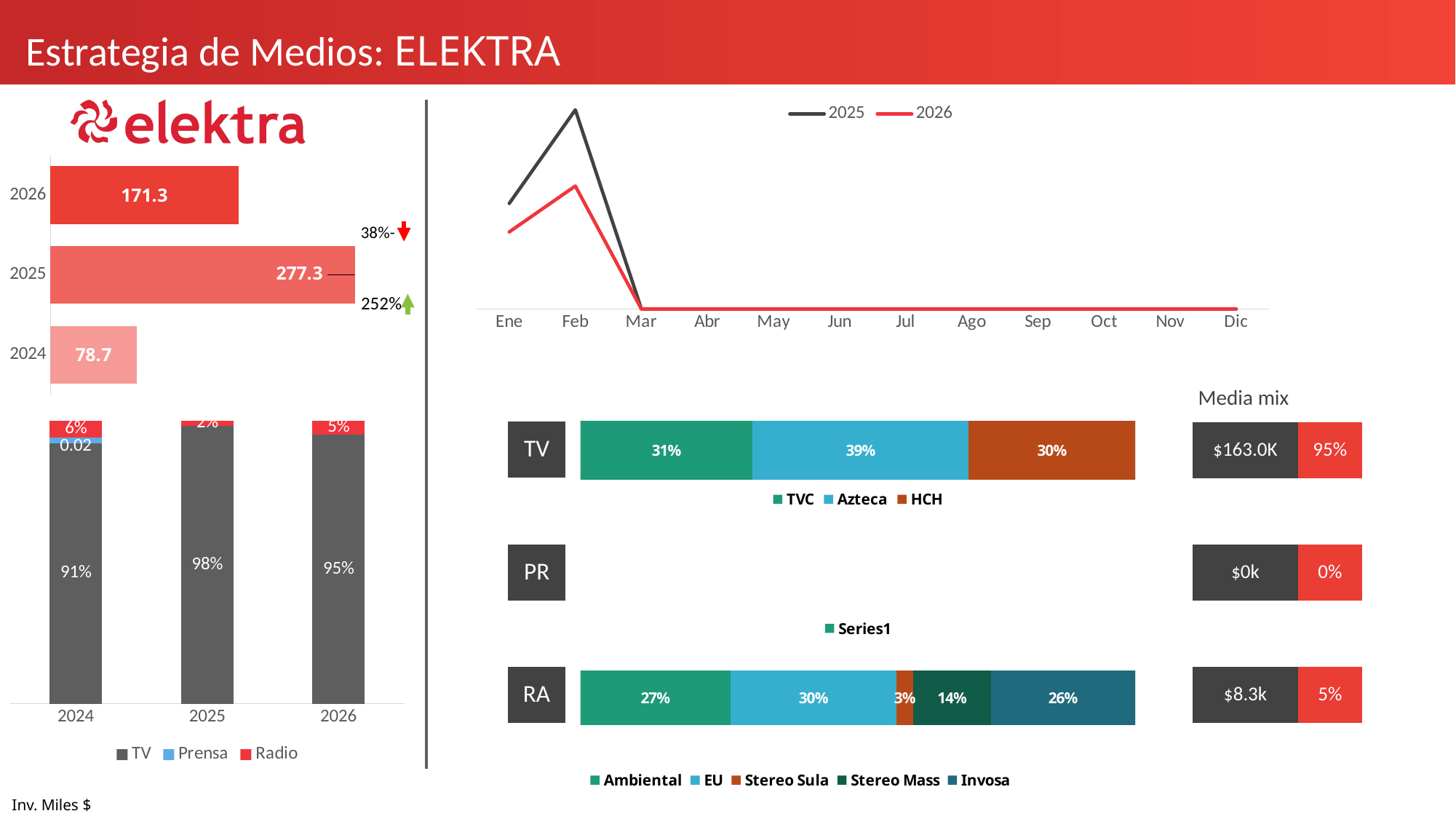
In the line chart of monthly investment at the top right, which series is higher in Feb, 2025 or 2026? 2025 In the RA stacked bar chart on the right, which station has the lowest share? Stereo Sula In the stacked bar chart of media share by year on the bottom left, how many series does the legend list? 3 In the horizontal bar chart of yearly investment on the left, which year has the lowest value? 2024 In the TV stacked bar chart on the right, what is the share for Azteca? 39% In the horizontal bar chart of yearly investment on the left, what is the difference between the 2025 and 2026 values? 106.0 In the line chart of monthly investment at the top right, how many series does the legend list? 2 In the horizontal bar chart of yearly investment on the left, what is the value for 2025? 277.3 In the stacked bar chart of media share by year on the bottom left, what is the Radio share for 2024? 6% In the Media mix table on the right, what is the investment value for RA? $8.3k In the stacked bar chart of media share by year on the bottom left, what is the TV share for 2025? 98% In the horizontal bar chart of yearly investment on the left, how many years are shown? 3